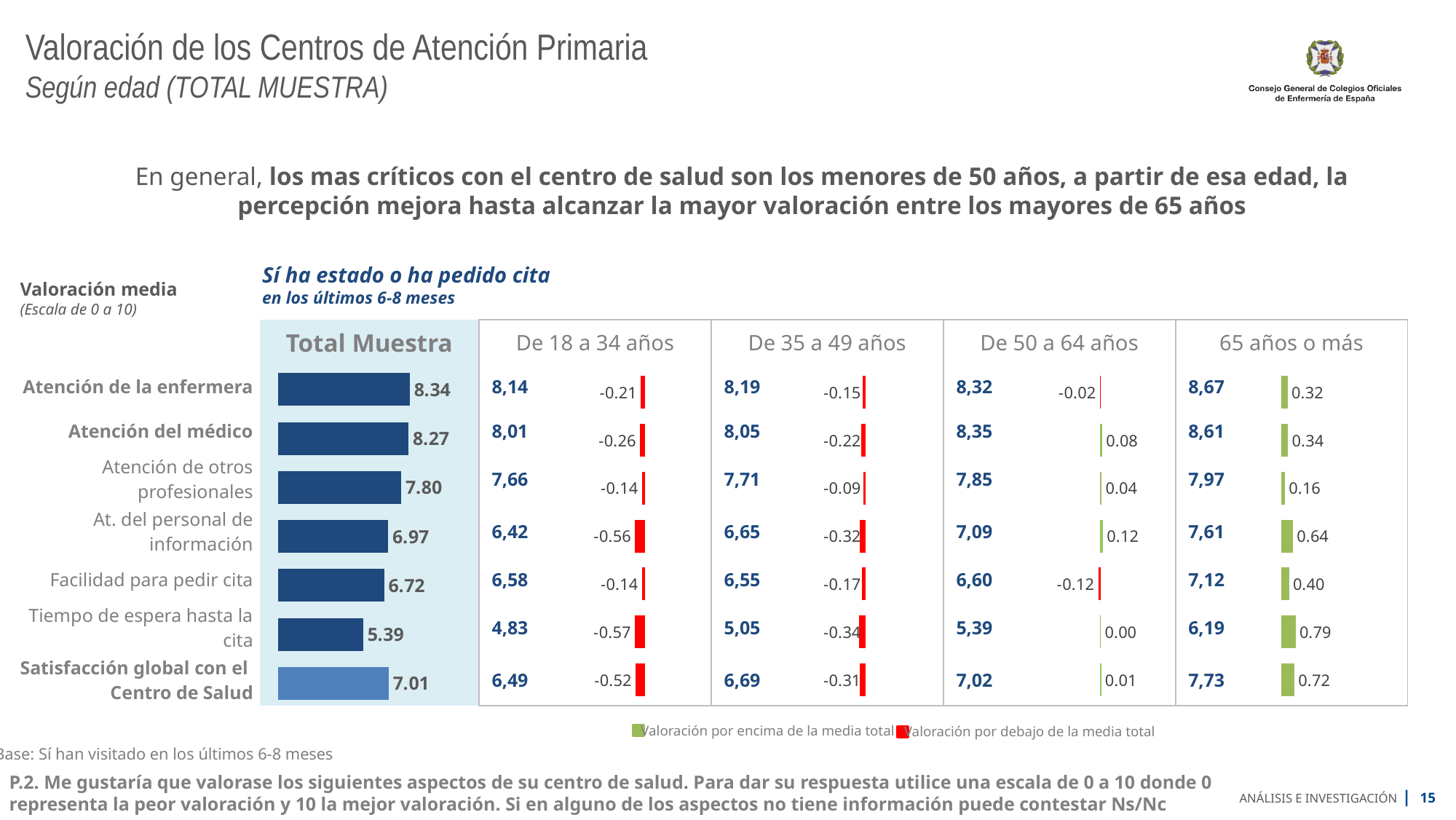
In the Total Muestra bar chart, what is the difference between Atención de la enfermera and Tiempo de espera hasta la cita? 2.95 In the Total Muestra bar chart, which is larger: At. del personal de información or Satisfacción global con el Centro de Salud? Satisfacción global con el Centro de Salud In the Total Muestra bar chart, which category has the lowest value? Tiempo de espera hasta la cita How many categories does the Total Muestra bar chart show? 7 In the Total Muestra bar chart, what is the value for Atención de la enfermera? 8.34 In the De 18 a 34 años column, what is the value for Tiempo de espera hasta la cita? 4,83 In the 65 años o más column, what is the deviation from the total mean for Tiempo de espera hasta la cita? 0.79 In the Total Muestra bar chart, what is the value for Tiempo de espera hasta la cita? 5.39 In the De 50 a 64 años column, what is the value for Atención del médico? 8,35 According to the legend, what does a green bar indicate? Valoración por encima de la media total In the Total Muestra bar chart, which category has the highest value? Atención de la enfermera What kind of chart is used for the Total Muestra column? Bar chart